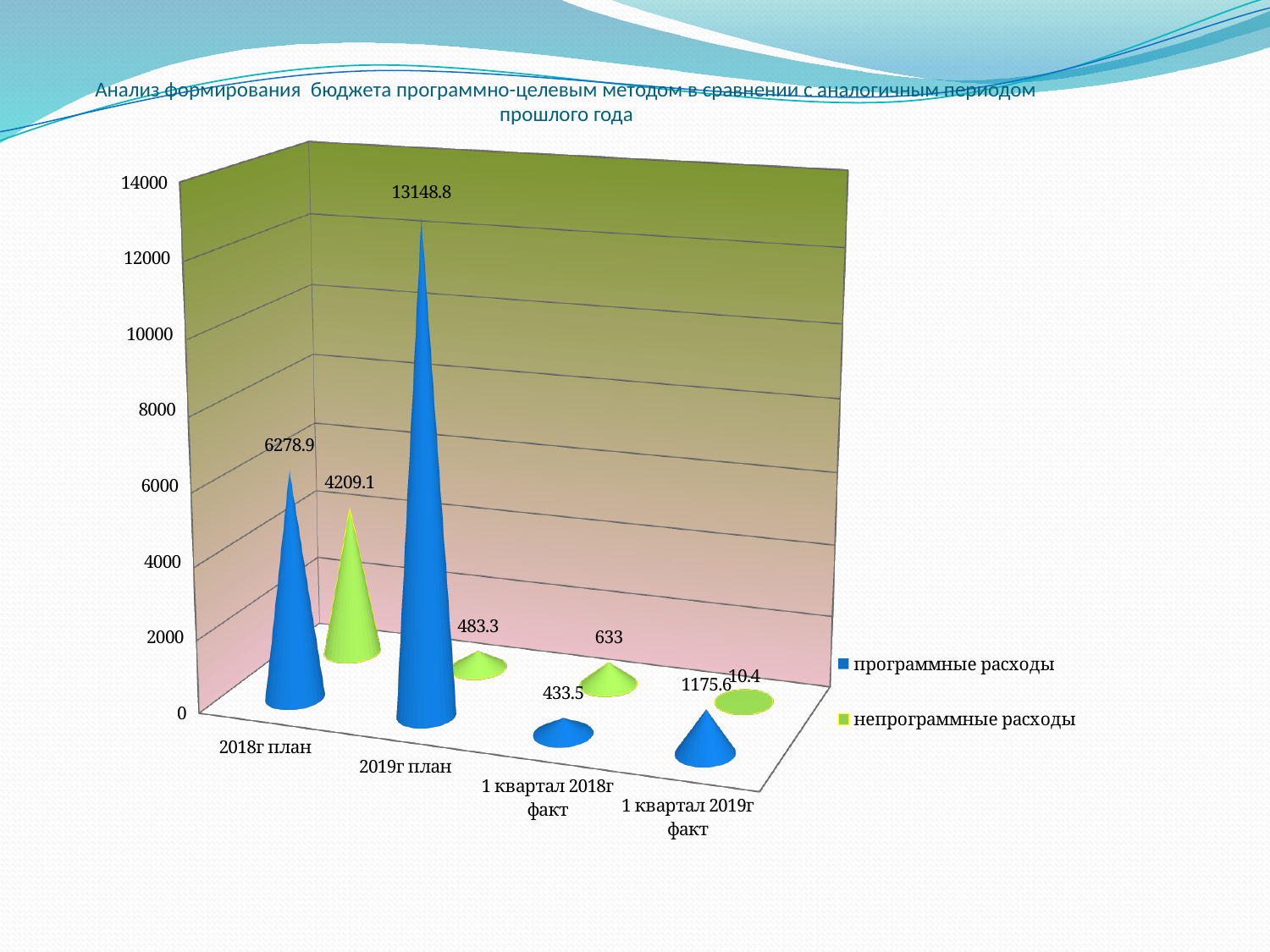
Which category has the lowest value of непрограммные расходы? 1 квартал 2019г факт Which category has the highest value of программные расходы? 2019г план What is the value of программные расходы for 1 квартал 2018г факт? 433.5 How many categories are shown on the x axis? 4 What is the value of программные расходы for 2019г план? 13148.8 What kind of chart is shown on the slide? bar chart Which is larger for 1 квартал 2018г факт: программные расходы or непрограммные расходы? непрограммные расходы What is the value of непрограммные расходы for 1 квартал 2019г факт? 10.4 What is the difference between программные расходы and непрограммные расходы for 2018г план? 2069.8 How many series does the legend list? 2 What is the value of непрограммные расходы for 2018г план? 4209.1 What colour represents непрограммные расходы in the legend? green